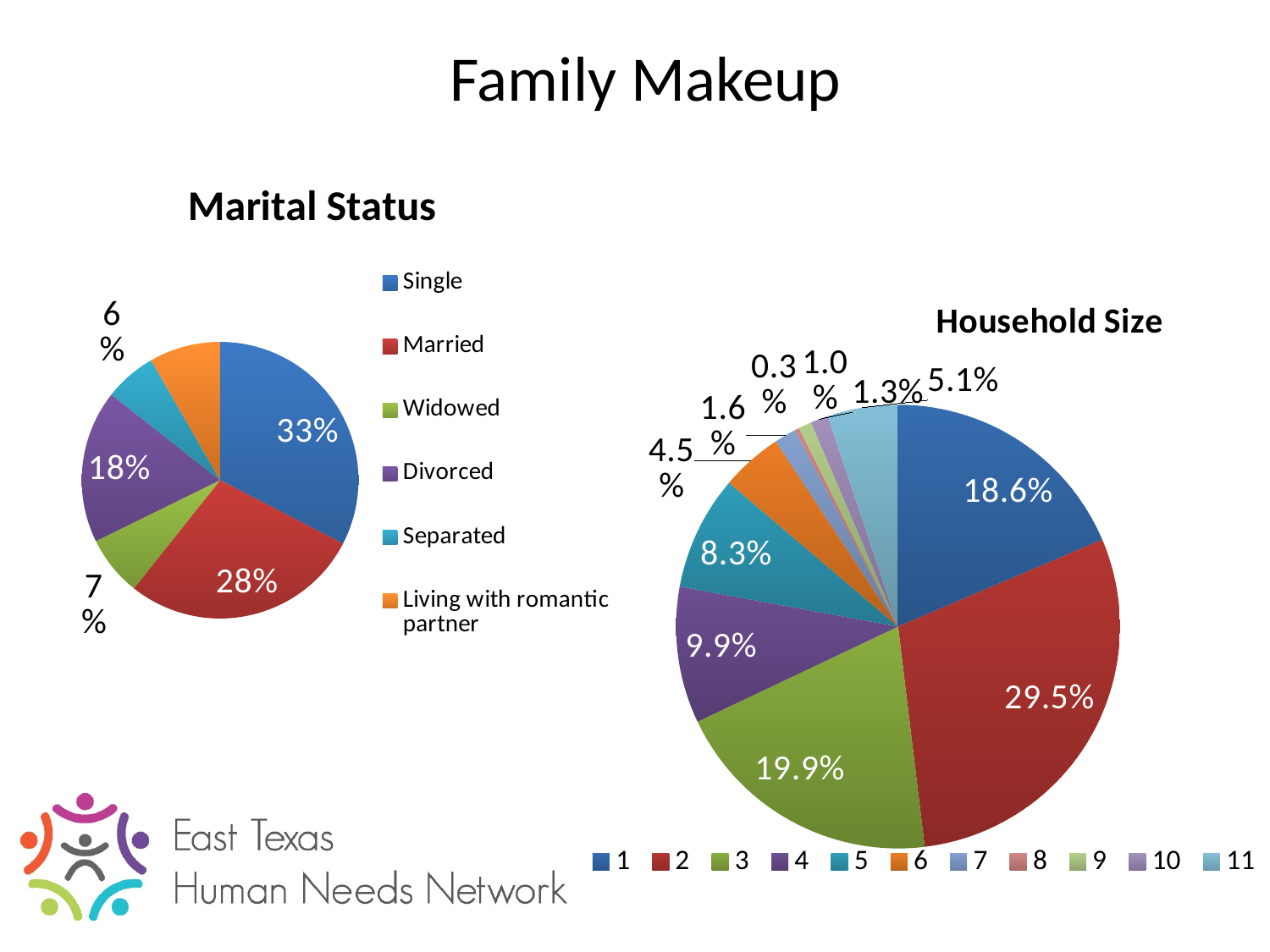
What kind of chart is the Marital Status chart? Pie chart In the Household Size chart, what percentage of households have a size of 1? 18.6% In the Marital Status chart, what percentage is Divorced? 18% In the Household Size chart, what percentage of households have a size of 2? 29.5% How many household size categories are shown in the Household Size chart? 11 In the Marital Status chart, how many percentage points larger is Single than Married? 5 percentage points In the Household Size chart, which has the larger share: household size 5 or household size 6? 5 In the Household Size chart, which household size has the smallest share? 8 In the Marital Status chart, which category has the largest share? Single In the Marital Status chart, what percentage is Married? 28% How many categories does the Marital Status legend list? 6 In the Marital Status chart, what percentage is Single? 33%